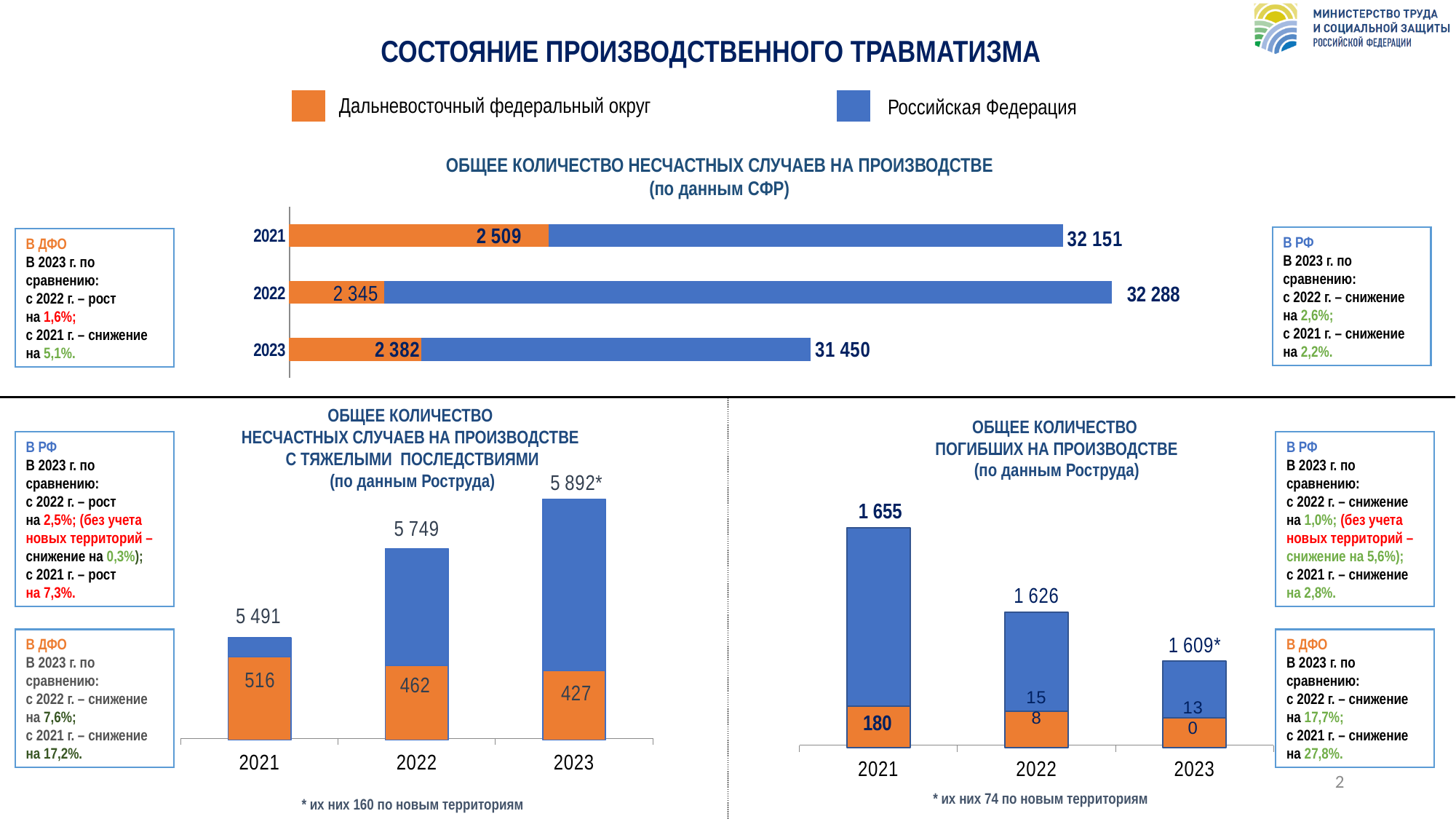
In the bottom-left chart (НЕСЧАСТНЫХ СЛУЧАЕВ С ТЯЖЕЛЫМИ ПОСЛЕДСТВИЯМИ), what is the difference between the Российская Федерация values for 2022 and 2021? 258 In the bottom-right chart (ОБЩЕЕ КОЛИЧЕСТВО ПОГИБШИХ НА ПРОИЗВОДСТВЕ), which year has the highest value for Российская Федерация? 2021 In the bottom-right chart (ОБЩЕЕ КОЛИЧЕСТВО ПОГИБШИХ НА ПРОИЗВОДСТВЕ), what is the value for Российская Федерация in 2021? 1 655 In the top chart (ОБЩЕЕ КОЛИЧЕСТВО НЕСЧАСТНЫХ СЛУЧАЕВ НА ПРОИЗВОДСТВЕ), which year has the lowest value for Российская Федерация? 2023 In the top chart (ОБЩЕЕ КОЛИЧЕСТВО НЕСЧАСТНЫХ СЛУЧАЕВ НА ПРОИЗВОДСТВЕ), what is the value for Российская Федерация in 2022? 32 288 What type of chart is the top chart (ОБЩЕЕ КОЛИЧЕСТВО НЕСЧАСТНЫХ СЛУЧАЕВ НА ПРОИЗВОДСТВЕ)? Bar chart In the bottom-left chart (НЕСЧАСТНЫХ СЛУЧАЕВ С ТЯЖЕЛЫМИ ПОСЛЕДСТВИЯМИ), what is the value for Дальневосточный федеральный округ in 2022? 462 In the top chart (ОБЩЕЕ КОЛИЧЕСТВО НЕСЧАСТНЫХ СЛУЧАЕВ НА ПРОИЗВОДСТВЕ), what is the difference between the Дальневосточный федеральный округ values for 2021 and 2022? 164 In the bottom-left chart (НЕСЧАСТНЫХ СЛУЧАЕВ С ТЯЖЕЛЫМИ ПОСЛЕДСТВИЯМИ), what is the value for Российская Федерация in 2023? 5 892* How many series does the legend at the top of the slide list? 2 In the bottom-left chart (НЕСЧАСТНЫХ СЛУЧАЕВ С ТЯЖЕЛЫМИ ПОСЛЕДСТВИЯМИ), do the Дальневосточный федеральный округ values rise or fall from 2021 to 2023? Fall In the top chart (ОБЩЕЕ КОЛИЧЕСТВО НЕСЧАСТНЫХ СЛУЧАЕВ НА ПРОИЗВОДСТВЕ), what is the value for Дальневосточный федеральный округ in 2021? 2 509